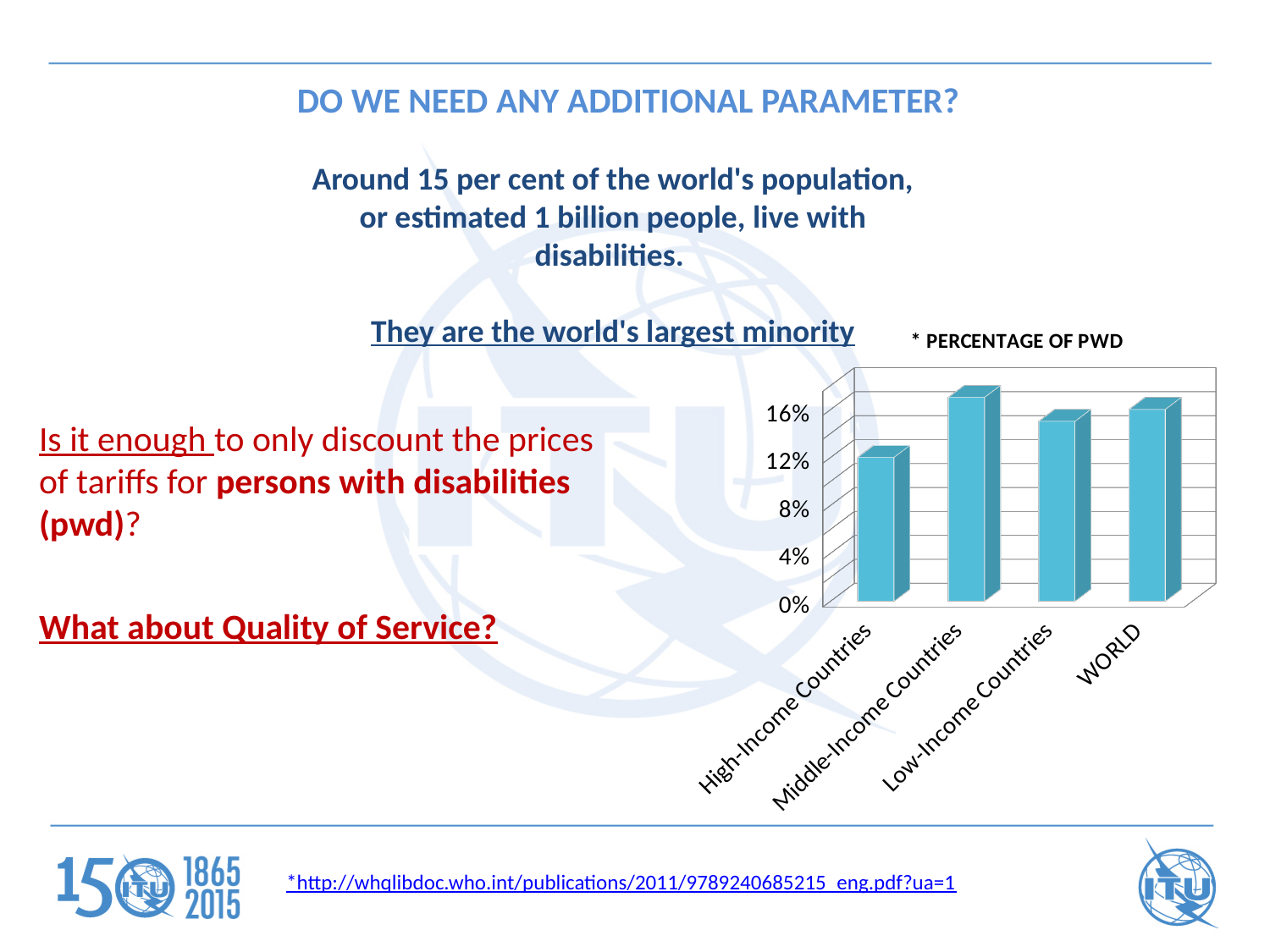
Which is larger in the chart: the value for Low-Income Countries or High-Income Countries? Low-Income Countries What kind of chart is shown on the slide? Bar chart Is the value for WORLD greater or less than 12%? greater Which category has the lowest percentage of PWD in the chart? High-Income Countries How many categories are shown on the x axis of the chart? 4 Which category has the highest percentage of PWD in the chart? Middle-Income Countries Is the value for Low-Income Countries greater or less than 12%? greater Which is larger in the chart: the value for Middle-Income Countries or High-Income Countries? Middle-Income Countries What is the title of the chart on the slide? * PERCENTAGE OF PWD Is the value for High-Income Countries greater or less than 16%? less